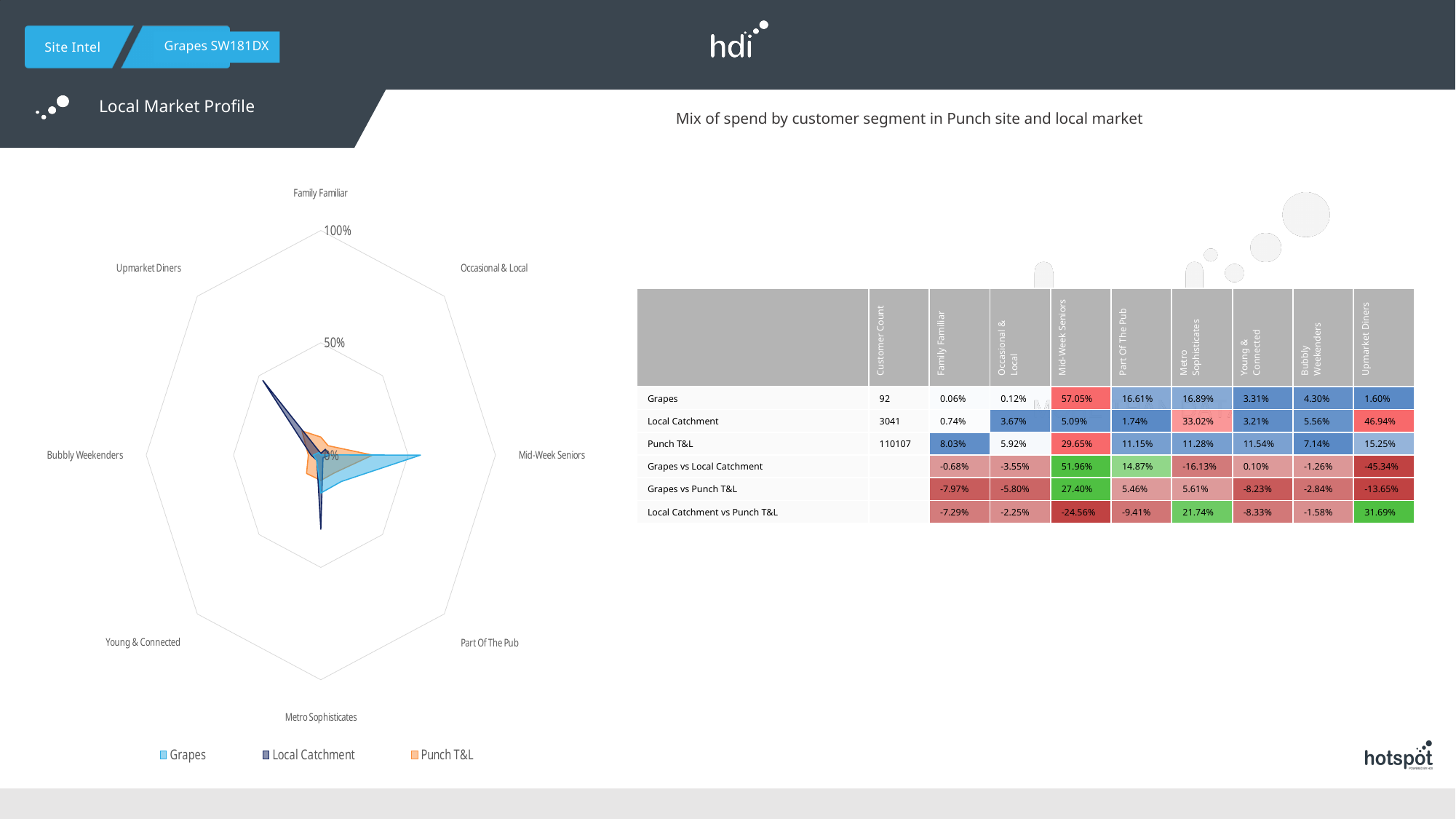
In the radar chart, is the Local Catchment value for Upmarket Diners greater or less than 50%? less What is the difference between the Grapes and Local Catchment values for Mid-Week Seniors? 51.96% Which series are listed in the radar chart's legend? Grapes, Local Catchment, Punch T&L For Mid-Week Seniors, which is larger: the Grapes value or the Punch T&L value? Grapes In the radar chart, which segment has the highest value for the Grapes series? Mid-Week Seniors According to the table, what is the Grapes value for Mid-Week Seniors? 57.05% How many customer segment categories does the radar chart have? 8 In the radar chart, which segment has the highest value for the Local Catchment series? Upmarket Diners According to the table, what is the Local Catchment value for Metro Sophisticates? 33.02% How many series does the radar chart's legend list? 3 In the radar chart, is the Grapes value for Mid-Week Seniors greater or less than 50%? greater What kind of chart is shown on the left of the slide? radar chart